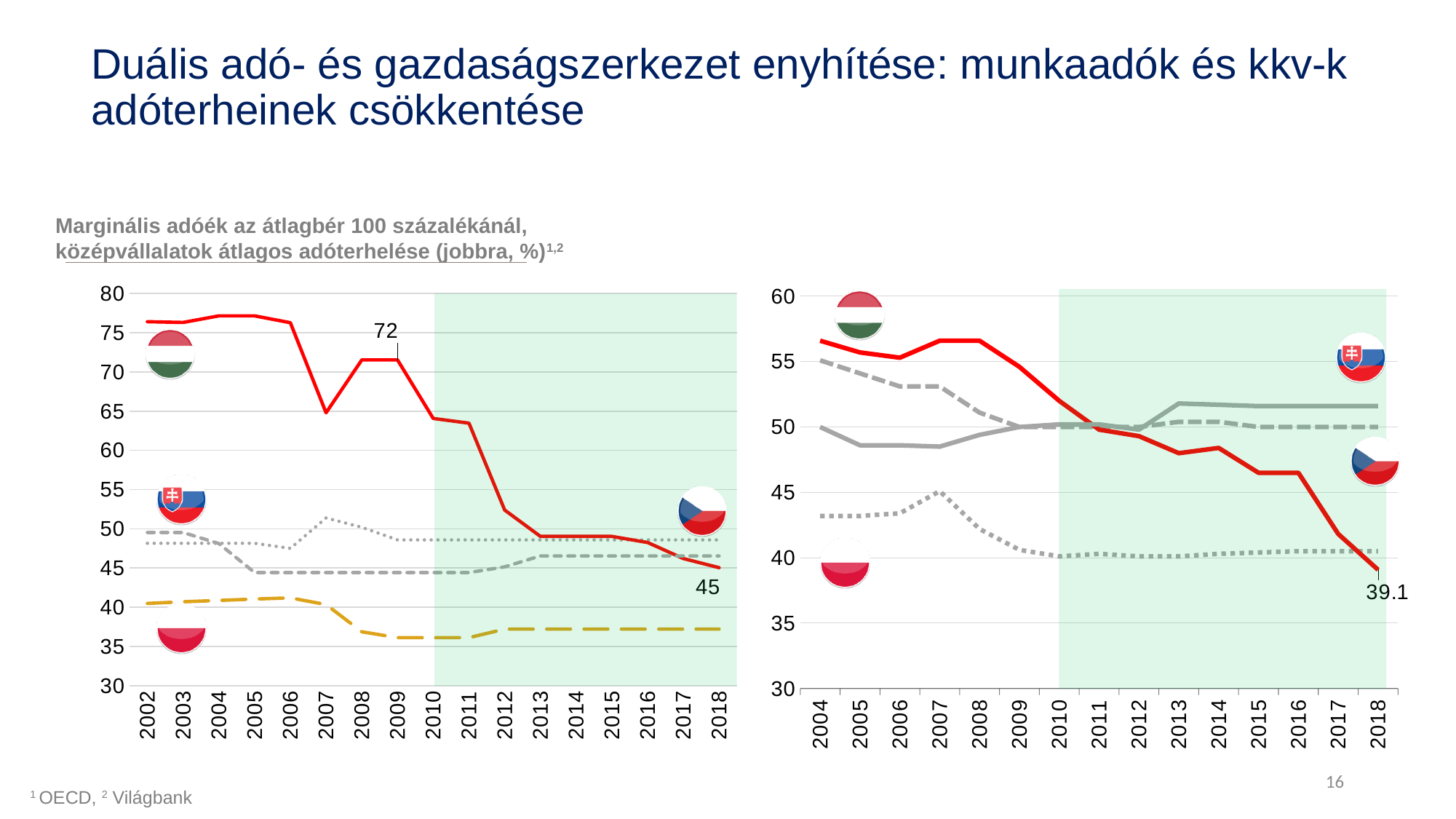
On the left chart, what is the difference between the red line's labelled values in 2009 and 2018? 27 On the right chart, is the red line's value in 2004 greater or less than 55? greater How many years are shown on the x axis of the left chart? 17 On the left chart, what value is labelled on the red line in 2009? 72 On the right chart, what value is labelled on the red line in 2018? 39.1 How many years are shown on the x axis of the right chart? 15 On the left chart, is the yellow dashed line's value in 2009 greater or less than 40? less On the left chart, does the red line rise or fall between 2009 and 2018? fall What kind of chart is the left chart on the slide? line chart On the left chart, is the red line's value in 2012 greater or less than 50? greater On the left chart, which line is lowest in 2018? the yellow dashed line On the left chart, what value is labelled on the red line in 2018? 45